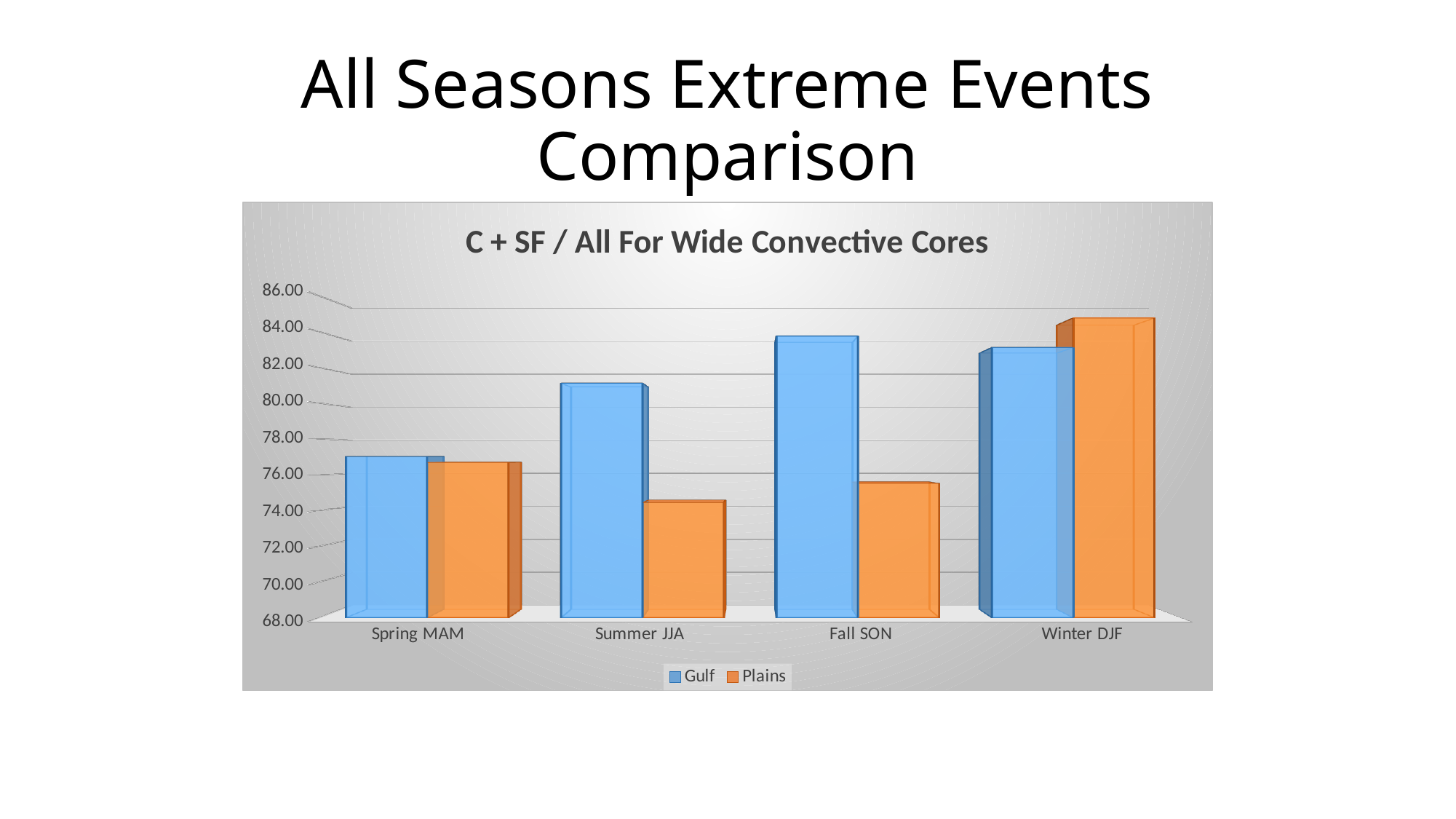
Is the Plains value for Fall SON greater or less than 78.00? less For which season is the Plains value highest? Winter DJF Is the Gulf value for Summer JJA greater or less than 80.00? greater For which season is the Gulf value lowest? Spring MAM In Summer JJA, which is larger, Gulf or Plains? Gulf Which series is shown in orange? Plains For which season is the Plains value lowest? Summer JJA How many season categories are shown on the x axis? 4 In Winter DJF, which is larger, Gulf or Plains? Plains How many series does the legend list? 2 What is the title of the chart? C + SF / All For Wide Convective Cores What kind of chart is shown on the slide? bar chart